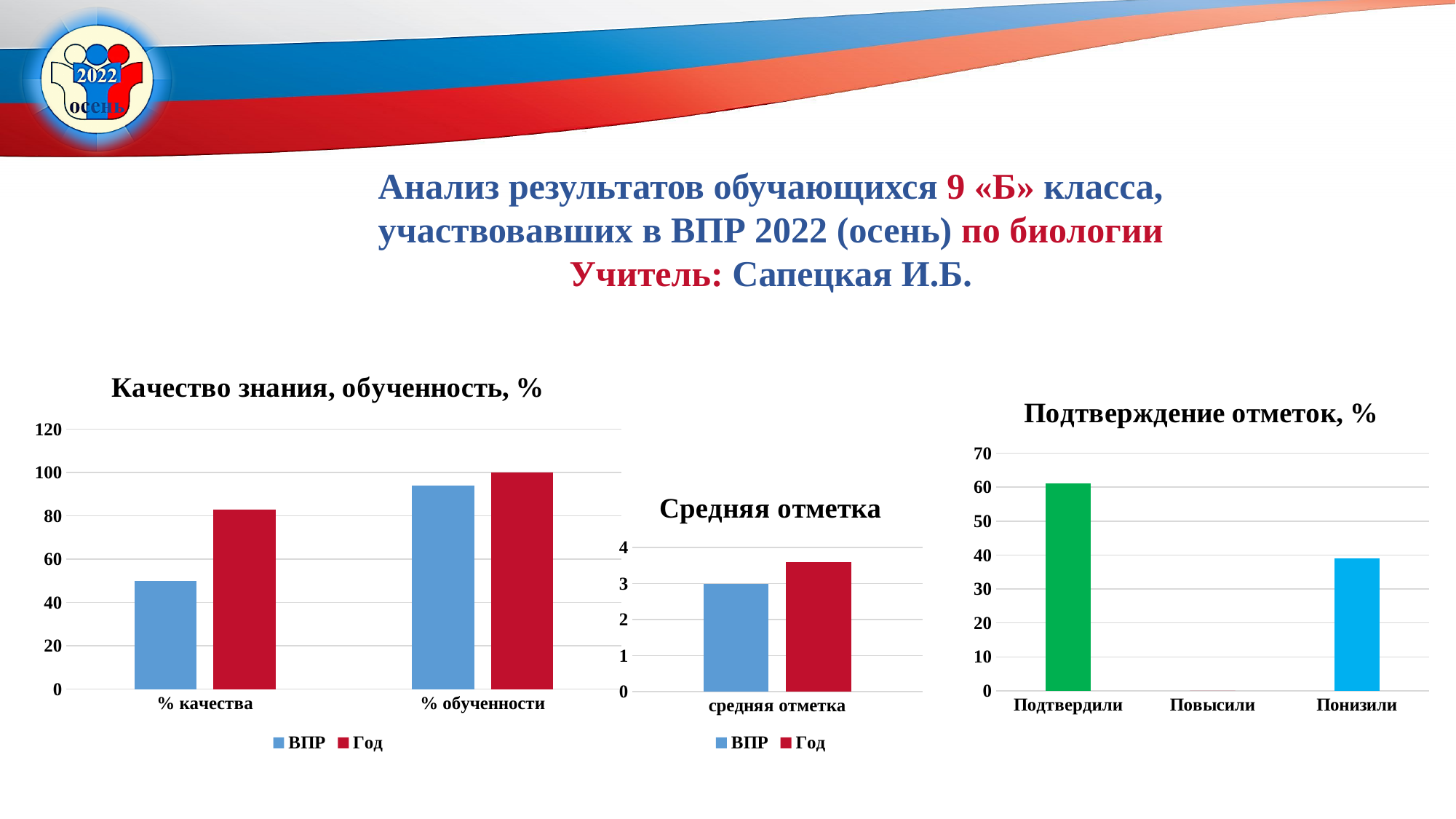
In the chart titled «Подтверждение отметок, %», is the value for Понизили greater or less than 50? less In the chart titled «Средняя отметка», what is the value for ВПР? 3 In the chart titled «Подтверждение отметок, %», which category has the highest value? Подтвердили In the chart titled «Средняя отметка», which is larger, ВПР or Год? Год In the chart titled «Качество знания, обученность, %», is the value for ВПР in the % качества category greater or less than 60? less In the chart titled «Подтверждение отметок, %», which category has the lowest value? Повысили In the chart titled «Качество знания, обученность, %», what is the value for Год in the % обученности category? 100 In the chart titled «Подтверждение отметок, %», is the value for Подтвердили greater or less than 50? greater In the chart titled «Качество знания, обученность, %», which is larger in the % качества category, ВПР or Год? Год How many series does the legend of the chart titled «Качество знания, обученность, %» list? 2 How many categories are shown on the x axis of the chart titled «Подтверждение отметок, %»? 3